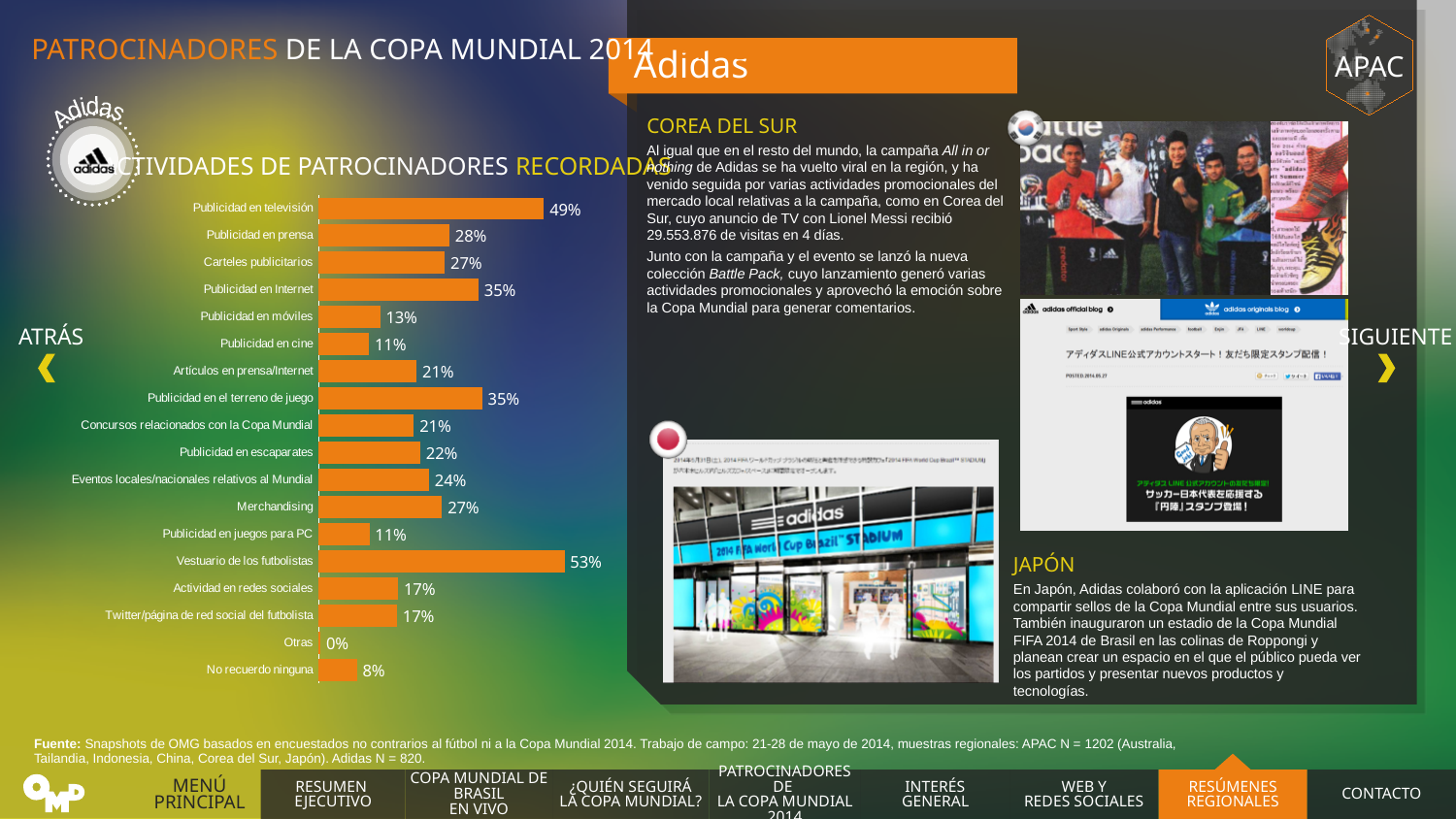
Which is larger, the value for Eventos locales/nacionales relativos al Mundial or the value for Publicidad en cine? Eventos locales/nacionales relativos al Mundial What is the value for Publicidad en televisión? 49% Which is larger, the value for Publicidad en Internet or the value for Publicidad en escaparates? Publicidad en Internet What is the value for No recuerdo ninguna? 8% What is the value for Publicidad en móviles? 13% How many categories are shown in the bar chart? 18 What is the difference between the values for Vestuario de los futbolistas and Merchandising? 26% What is the value for Vestuario de los futbolistas? 53% What kind of chart is shown on the slide? Bar chart What is the difference between the values for Publicidad en televisión and Publicidad en prensa? 21% Which category has the highest value in the bar chart? Vestuario de los futbolistas Which category has the lowest value in the bar chart? Otras